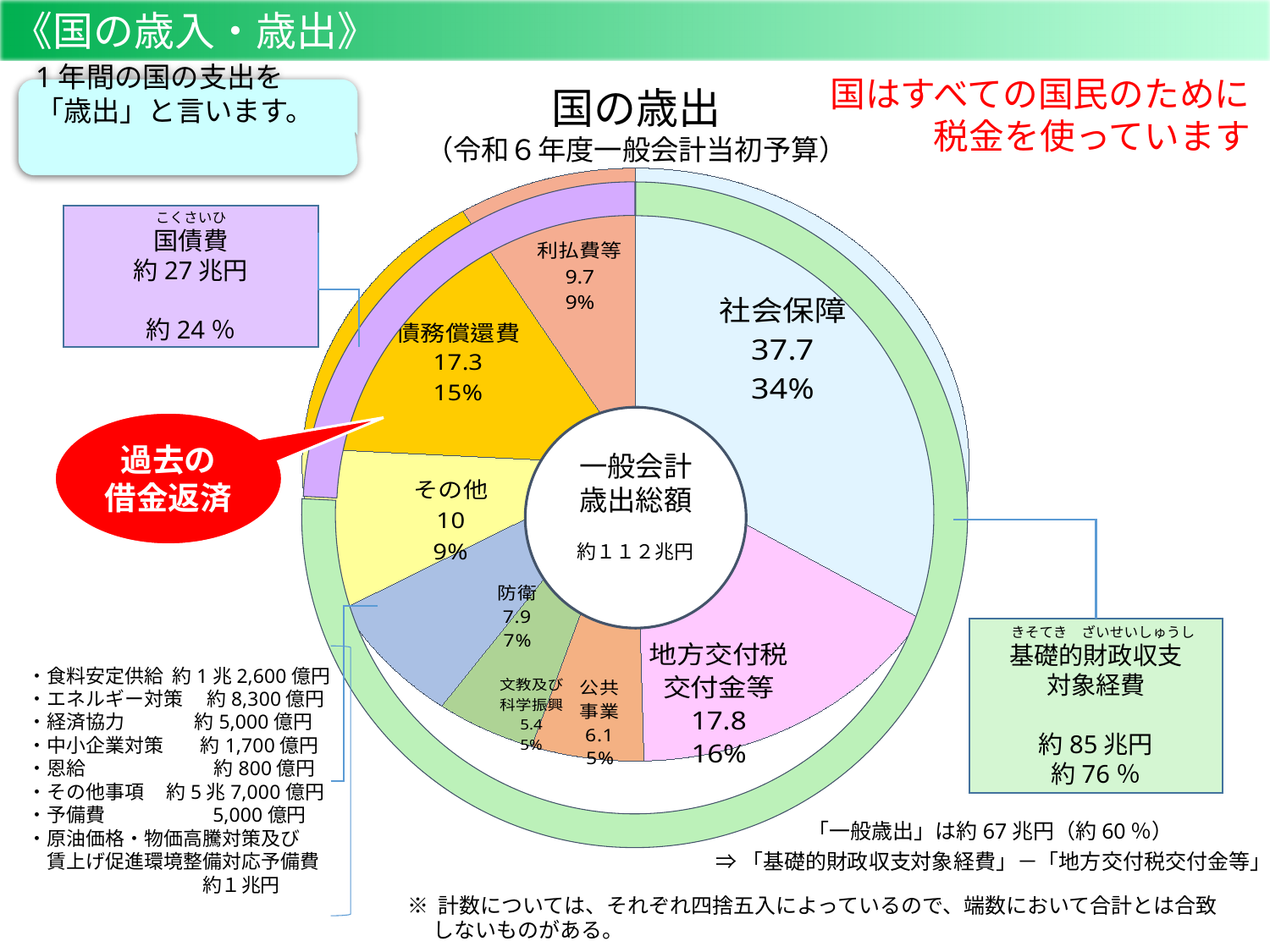
What is the value shown for 社会保障 in the 国の歳出 pie chart? 37.7 Which category has the largest slice in the 国の歳出 pie chart? 社会保障 What percentage share does 社会保障 have in the 国の歳出 pie chart? 34% Which is larger, the value for 利払費等 or the value for 防衛? 利払費等 What kind of chart is shown on the slide? Pie chart What is the value shown for 債務償還費? 17.3 What total amount is shown in the centre of the pie chart for 一般会計歳出総額? 約１１２兆円 What is the difference between the values for 社会保障 and 地方交付税交付金等? 19.9 What is the value shown for 地方交付税交付金等? 17.8 How many categories (slices) are shown in the 国の歳出 pie chart? 8 What percentage share does 防衛 have in the pie chart? 7% Which category has the smallest slice in the 国の歳出 pie chart? 文教及び科学振興